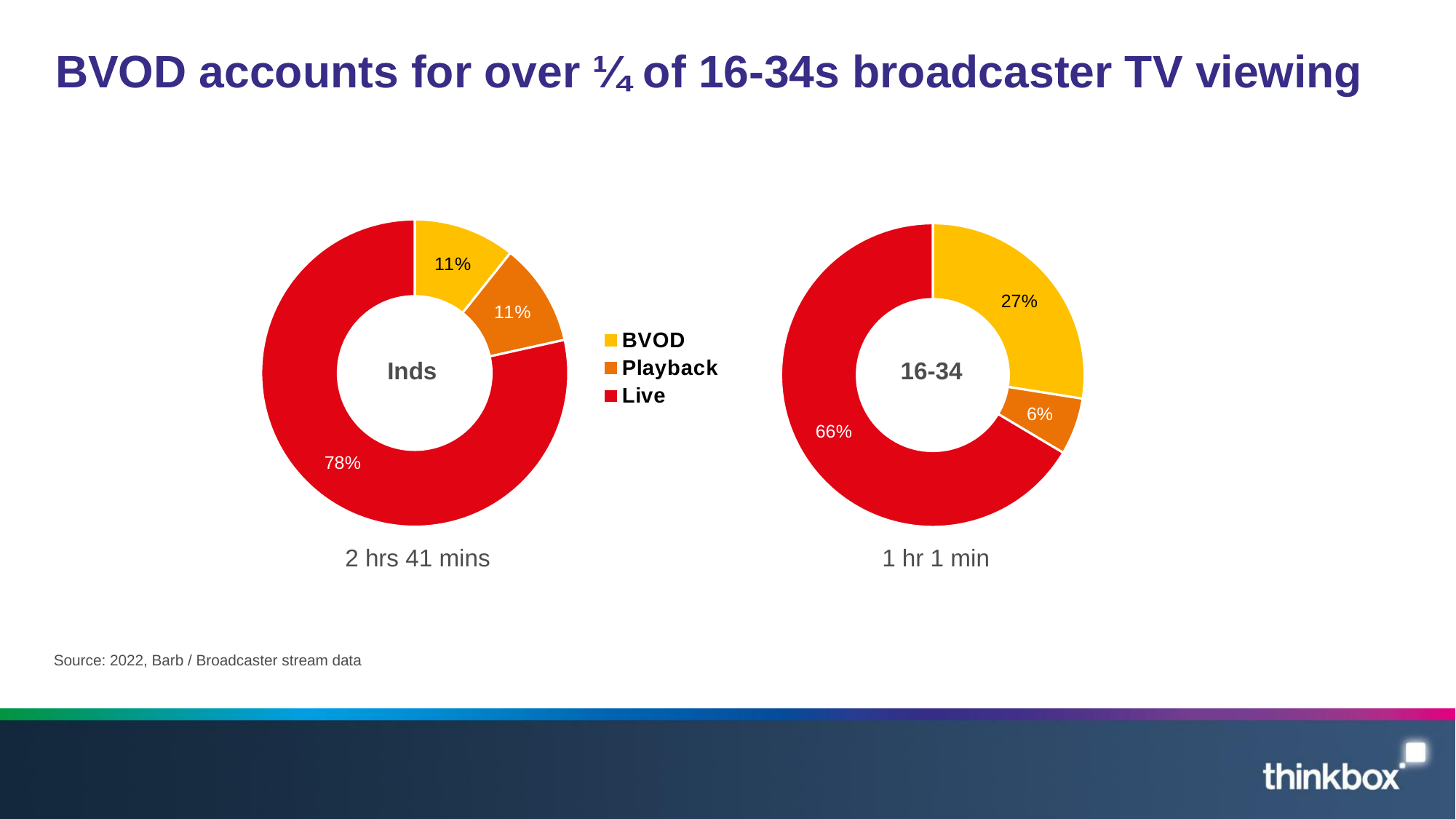
In the Inds chart, what share of viewing is Live? 78% What is the difference between the Live share in the Inds chart and the Live share in the 16-34 chart? 12 percentage points In the 16-34 chart, which category has the smallest share? Playback In the 16-34 chart, what share of viewing is BVOD? 27% In the Inds chart, what share of viewing is BVOD? 11% Is the BVOD share larger in the Inds chart or the 16-34 chart? 16-34 How many series does the legend list? 3 What total viewing time is shown beneath the Inds chart? 2 hrs 41 mins In the 16-34 chart, what share of viewing is Playback? 6% In the 16-34 chart, which category has the largest share? Live Which colour represents Live in the legend? Red What kind of chart is used on this slide? Doughnut (pie) chart